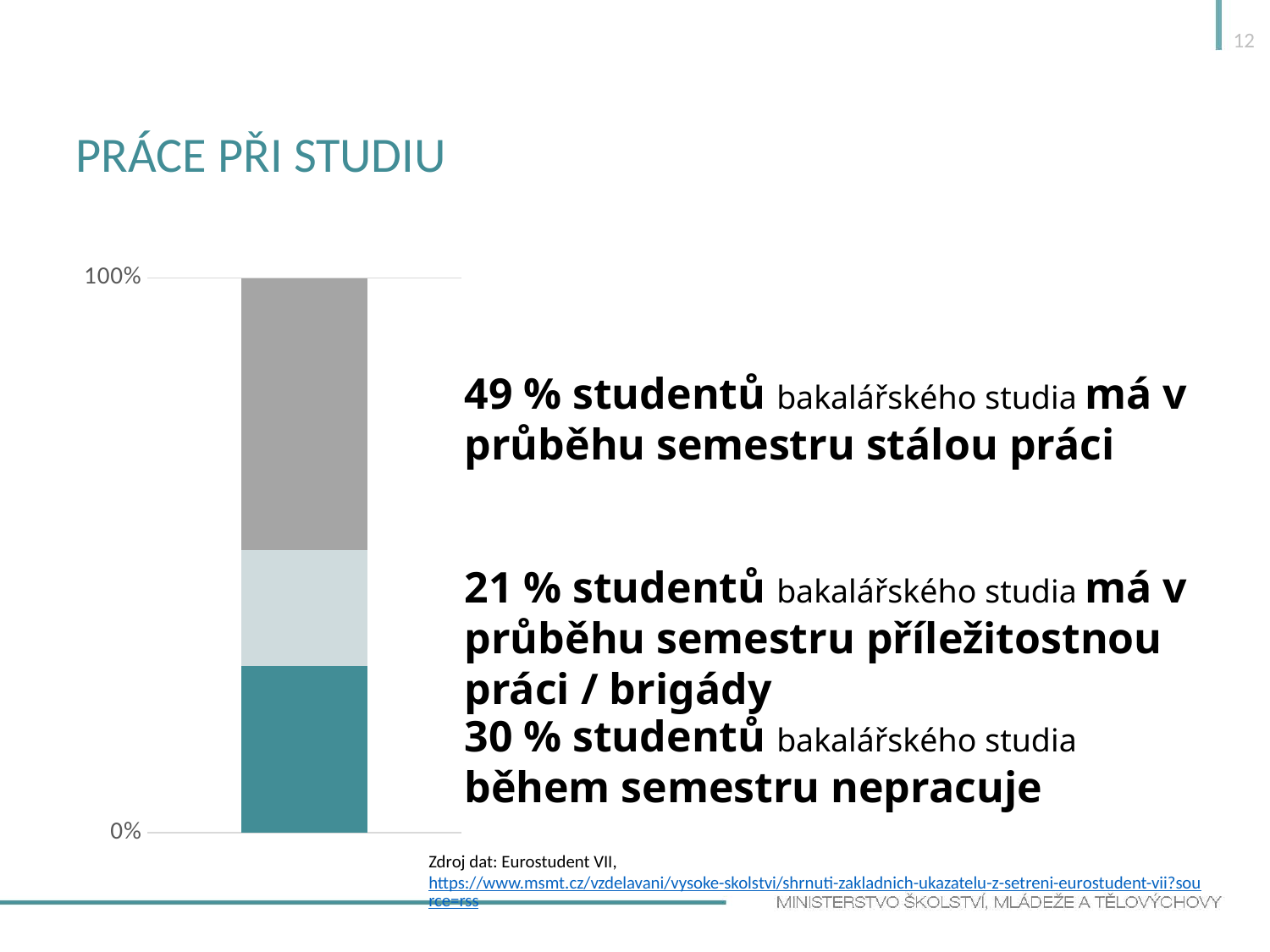
According to the text beside the chart, what share of bachelor students has occasional work / temporary jobs during the semester? 21 % What colour is the bottom segment of the stacked bar? teal According to the text beside the chart, what share of bachelor students does not work during the semester? 30 % How many segments make up the stacked bar? 3 How many bars does the chart contain? 1 What value does the top of the stacked bar reach on the vertical axis? 100% What is the title of the slide containing the chart? PRÁCE PŘI STUDIU Is the bottom segment of the bar larger or smaller than the middle segment? larger Which segment of the stacked bar is the largest: the top, middle or bottom? top Which segment of the stacked bar is the smallest: the top, middle or bottom? middle What kind of chart is shown on the slide? stacked bar chart According to the text beside the chart, what share of bachelor students has a steady job during the semester? 49 %